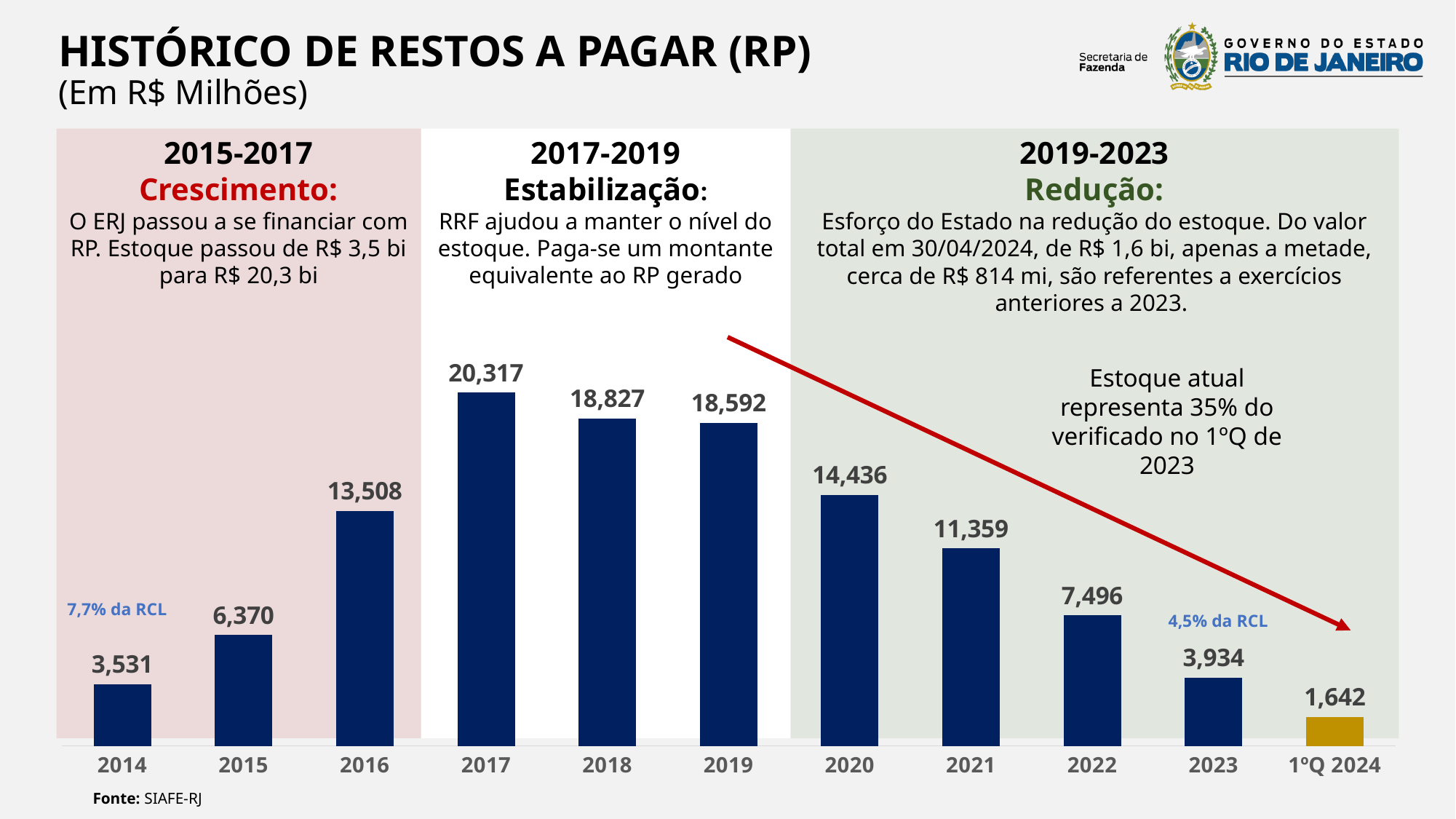
Which is larger, the value for 2018 or the value for 2019? 2018 Which year has the highest value? 2017 What is the value for 2017? 20,317 Do the values rise or fall from 2019 to 2023? Fall What is the difference between the values for 2017 and 2014? 16,786 Which category has the lowest value? 1ºQ 2024 What kind of chart is shown on the slide? Bar chart How many bars are plotted in the chart? 11 What is the title of the chart? HISTÓRICO DE RESTOS A PAGAR (RP) What is the value for 2021? 11,359 What is the difference between the values for 2022 and 2023? 3,562 What is the value for 1ºQ 2024? 1,642